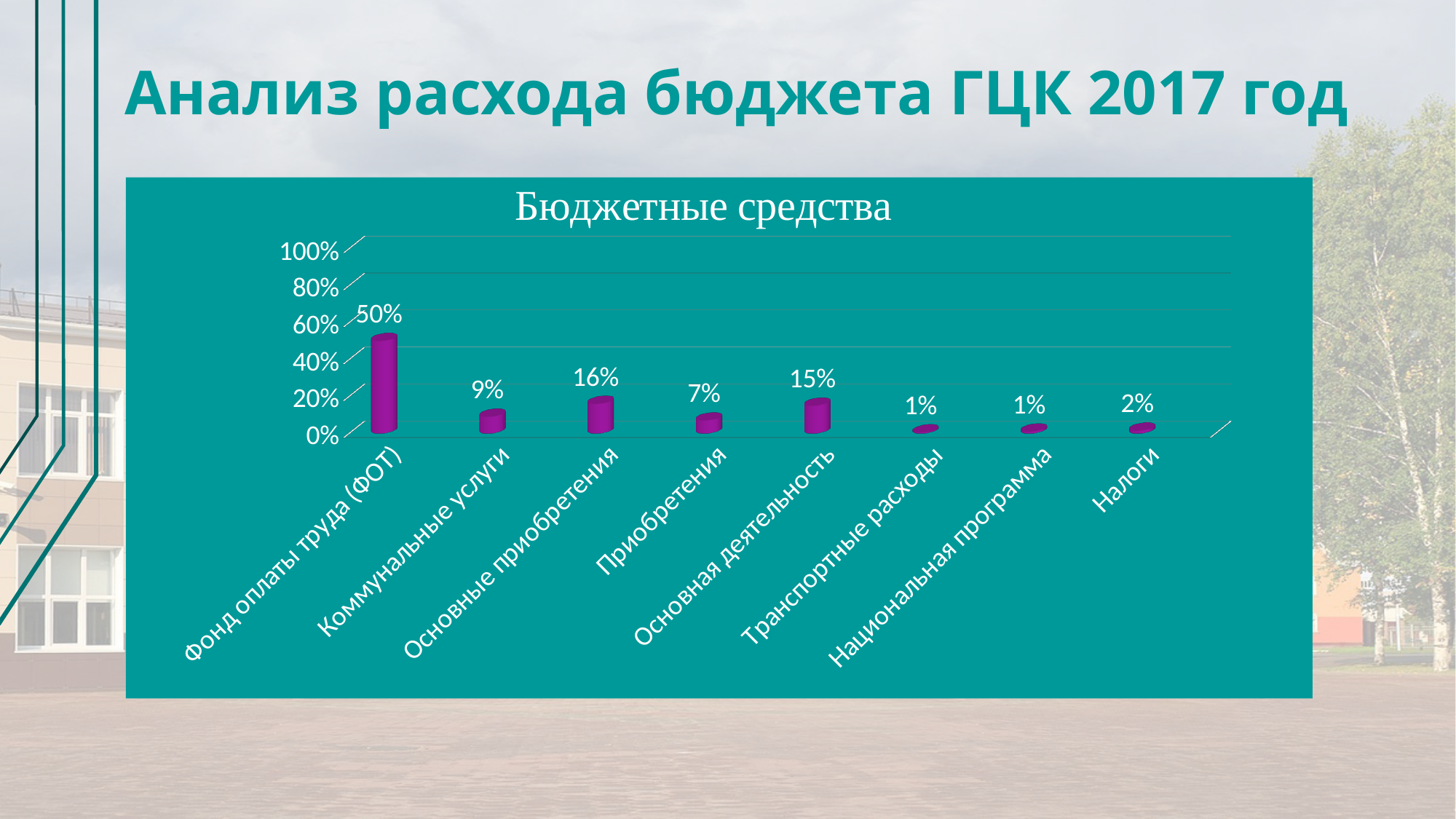
What kind of chart is this? bar chart Which is larger, the value for Коммунальные услуги or the value for Приобретения? Коммунальные услуги Is the value for Фонд оплаты труда (ФОТ) greater or less than 40%? greater What is the value for Коммунальные услуги? 9% How many categories are shown on the x axis? 8 What is the value for Налоги? 2% What is the title of the chart? Бюджетные средства What is the value for Фонд оплаты труда (ФОТ)? 50% What is the value for Основные приобретения? 16% Which category has the highest value? Фонд оплаты труда (ФОТ) What is the difference between the values for Фонд оплаты труда (ФОТ) and Основная деятельность? 35% What is the difference between the values for Основные приобретения and Приобретения? 9%